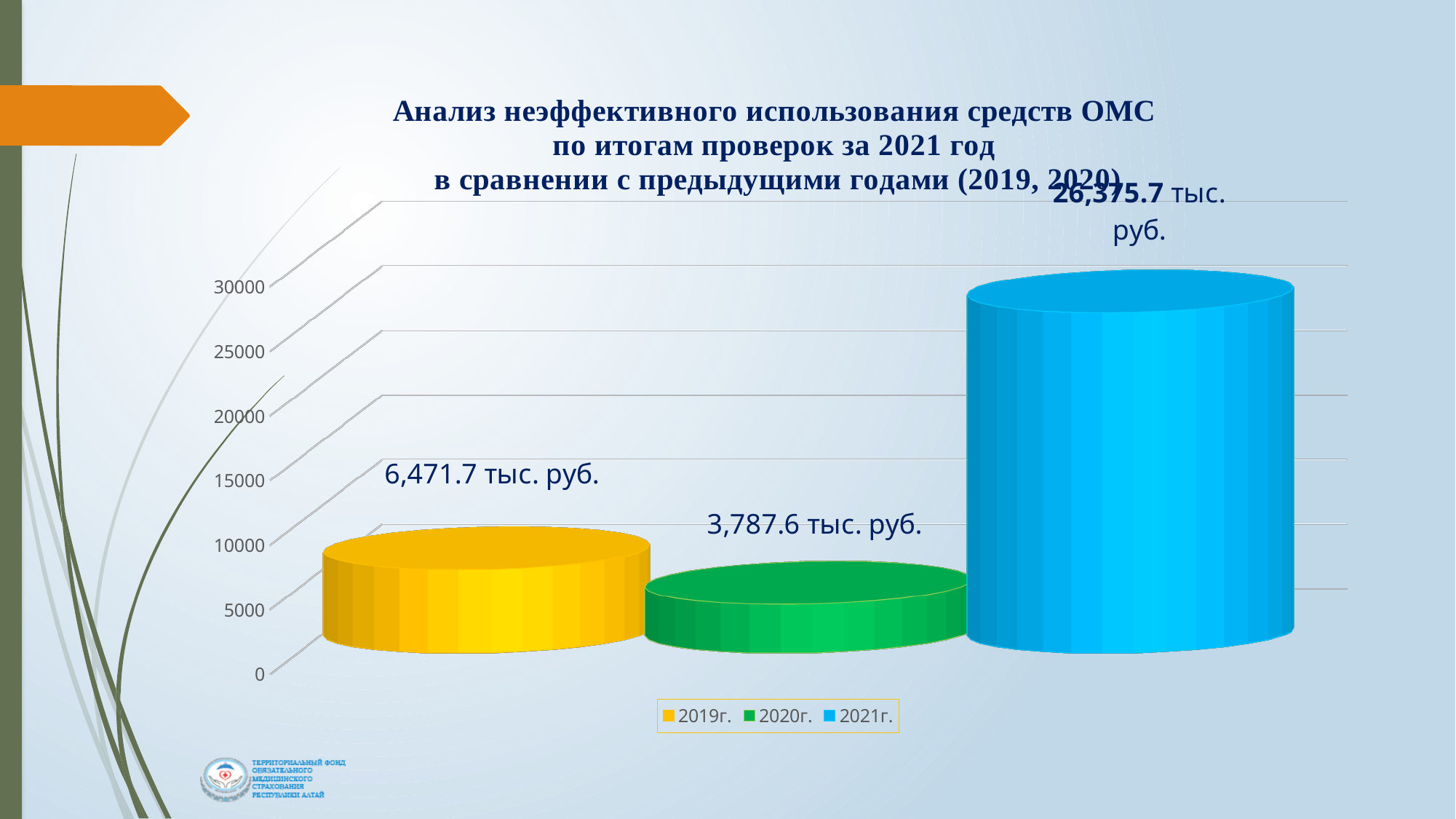
Which year has the lowest value? 2020г. What colour is the bar for 2021г.? blue Is the value for 2021г. greater or less than 25000? greater What value is shown for 2020г.? 3,787.6 тыс. руб. What kind of chart is shown on the slide? bar chart What is the difference between the values for 2021г. and 2019г.? 19,904.0 тыс. руб. How many series does the legend list? 3 What is the difference between the values for 2019г. and 2020г.? 2,684.1 тыс. руб. Which is larger, the value for 2019г. or the value for 2020г.? 2019г. What value is shown for 2019г.? 6,471.7 тыс. руб. What value is shown for 2021г.? 26,375.7 тыс. руб. Which year has the highest value? 2021г.